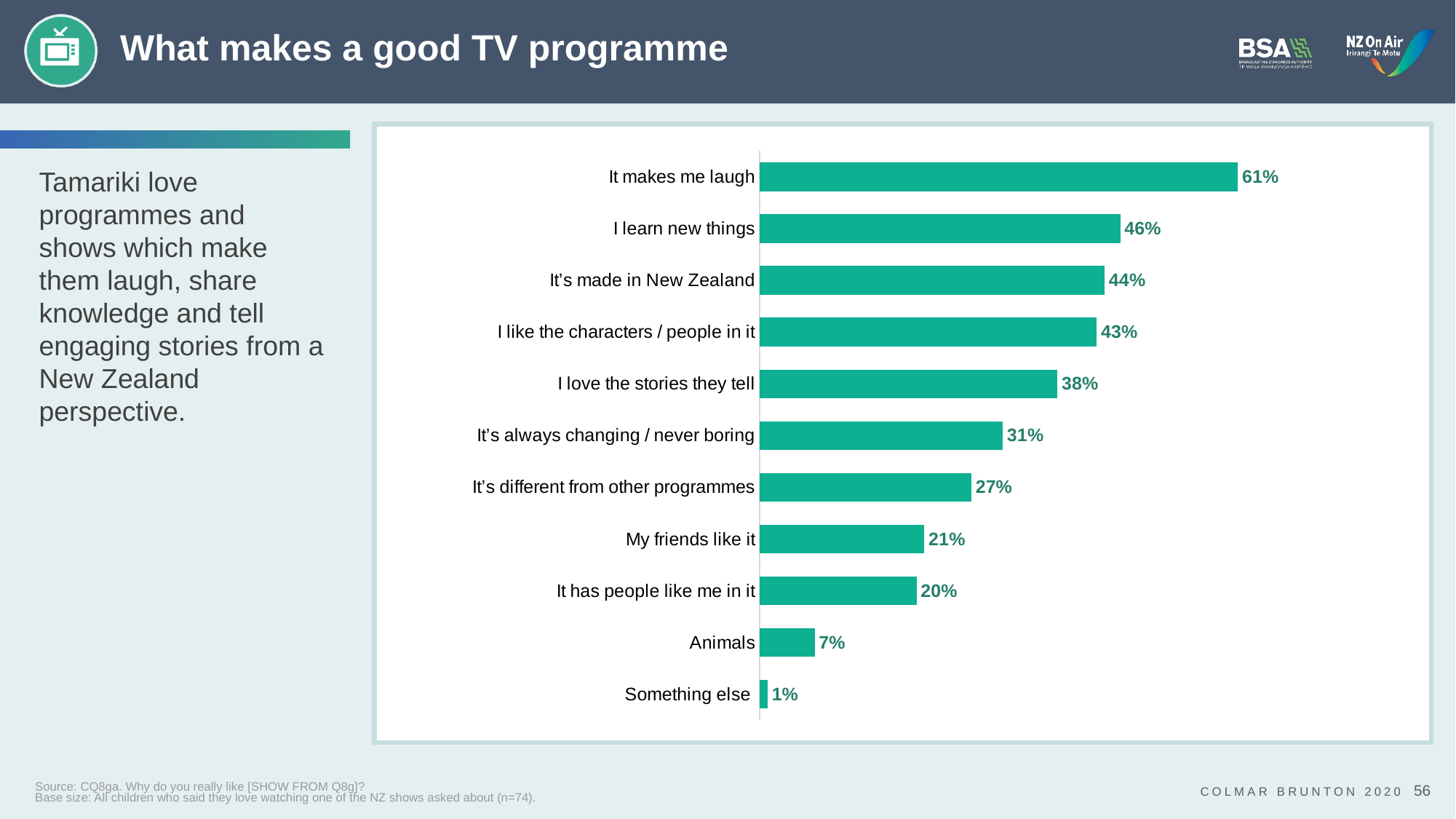
How many categories are shown in the chart? 11 What is the value for "I like the characters / people in it"? 43% What percentage of children said "It makes me laugh" is what makes a good TV programme? 61% What is the value for "My friends like it"? 21% Which is larger: "It's always changing / never boring" or "It's different from other programmes"? It's always changing / never boring What is the difference between "I learn new things" and "I love the stories they tell"? 8% What is the value for "It's made in New Zealand"? 44% What is the title of the slide containing the chart? What makes a good TV programme What is the difference between "It has people like me in it" and "Animals"? 13% What kind of chart is shown on the slide? Bar chart Which category has the highest value? It makes me laugh Which category has the lowest value? Something else